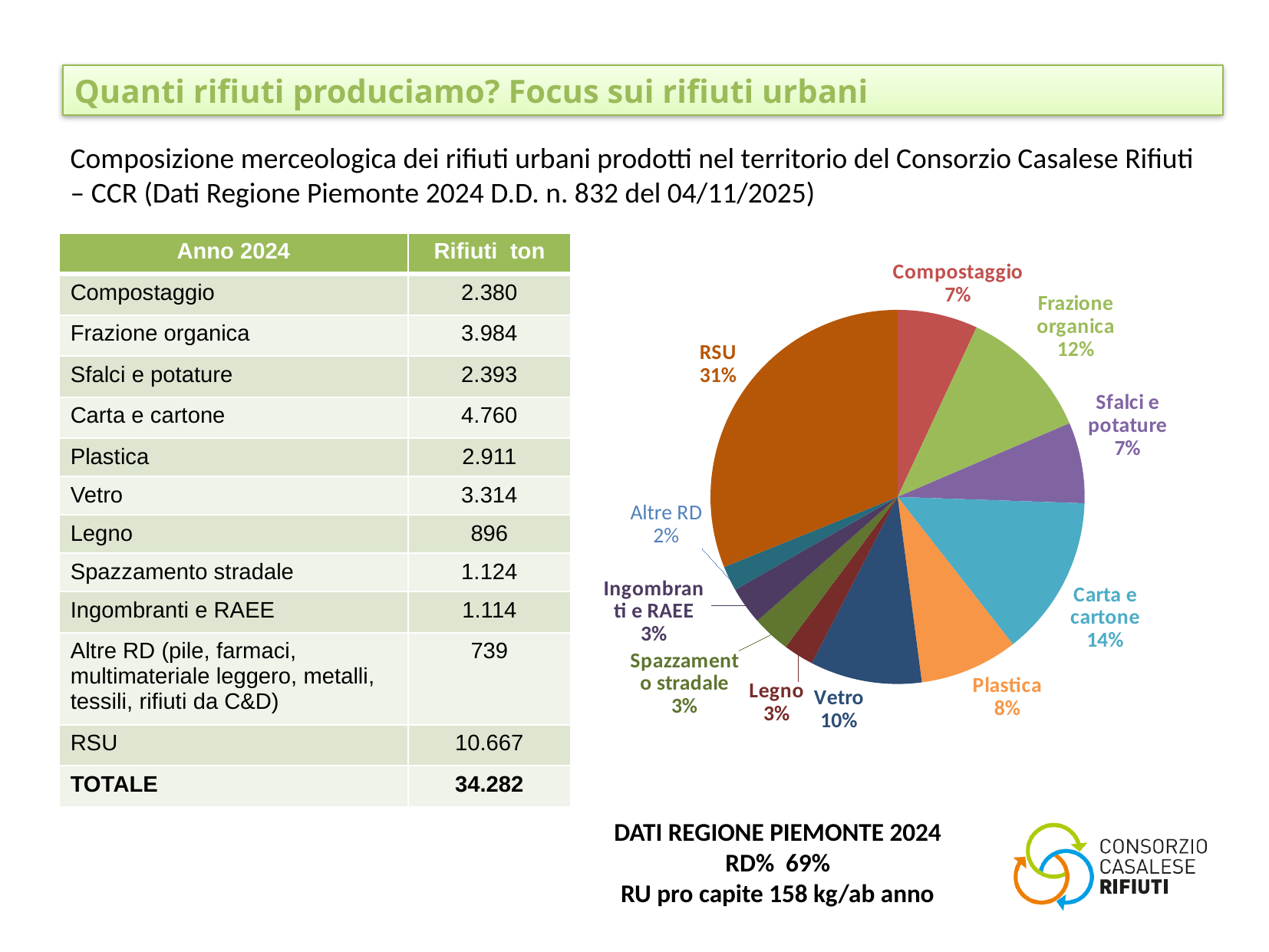
What percentage is shown for Carta e cartone in the pie chart? 14% Which slice is larger in the pie chart, Plastica or Vetro? Vetro What percentage is shown for Vetro in the pie chart? 10% What is the difference in percentage points between RSU and Carta e cartone in the pie chart? 17 Which category has the smallest slice of the pie chart? Altre RD How many slices does the pie chart have? 11 What percentage is shown for Frazione organica in the pie chart? 12% What share of the pie does RSU represent? 31% What is the difference in percentage points between Frazione organica and Plastica in the pie chart? 4 Which category has the largest slice of the pie chart? RSU What colour is the RSU slice in the pie chart? orange-brown What kind of chart is shown on the slide? pie chart